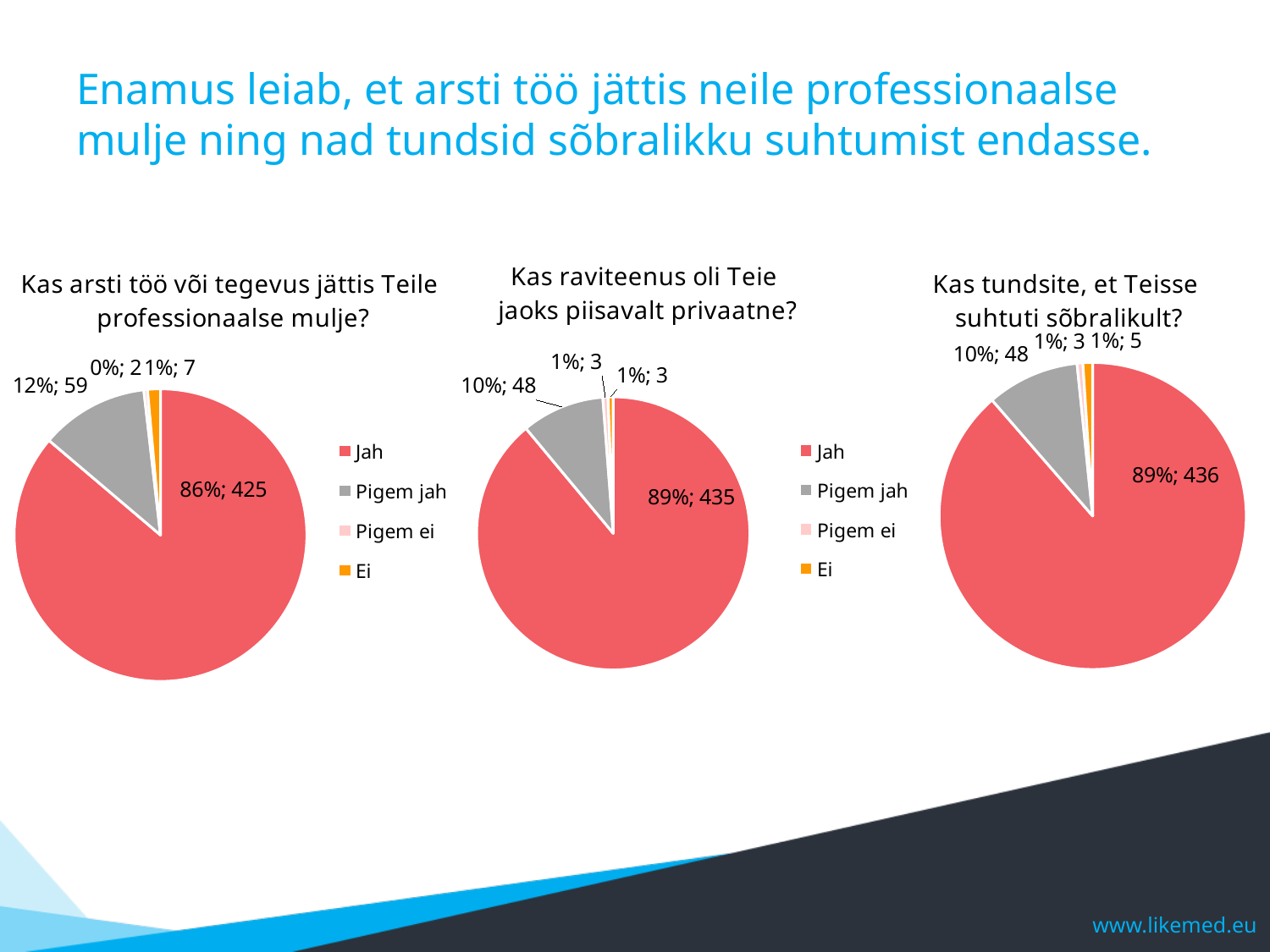
In the chart titled "Kas raviteenus oli Teie jaoks piisavalt privaatne?", what count is shown for the "Pigem jah" slice? 48 In the chart titled "Kas raviteenus oli Teie jaoks piisavalt privaatne?", what percentage is shown for the "Jah" slice? 89% In the chart titled "Kas arsti töö või tegevus jättis Teile professionaalse mulje?", which category has the largest slice? Jah In the chart titled "Kas raviteenus oli Teie jaoks piisavalt privaatne?", which is larger, the count for "Jah" or the count for "Pigem jah"? Jah In the chart titled "Kas tundsite, et Teisse suhtuti sõbralikult?", what count is shown for the "Ei" slice? 5 How many entries does the legend next to the chart titled "Kas arsti töö või tegevus jättis Teile professionaalse mulje?" list? 4 In the chart titled "Kas tundsite, et Teisse suhtuti sõbralikult?", what is the difference between the counts for "Jah" and "Pigem jah"? 388 In the chart titled "Kas tundsite, et Teisse suhtuti sõbralikult?", what count is shown for the "Jah" slice? 436 What kind of chart is used for "Kas raviteenus oli Teie jaoks piisavalt privaatne?"? Pie chart In the chart titled "Kas arsti töö või tegevus jättis Teile professionaalse mulje?", what count is shown for the "Jah" slice? 425 In the chart titled "Kas arsti töö või tegevus jättis Teile professionaalse mulje?", what percentage is shown for the "Pigem jah" slice? 12% In the chart titled "Kas arsti töö või tegevus jättis Teile professionaalse mulje?", which category has the smallest slice? Pigem ei